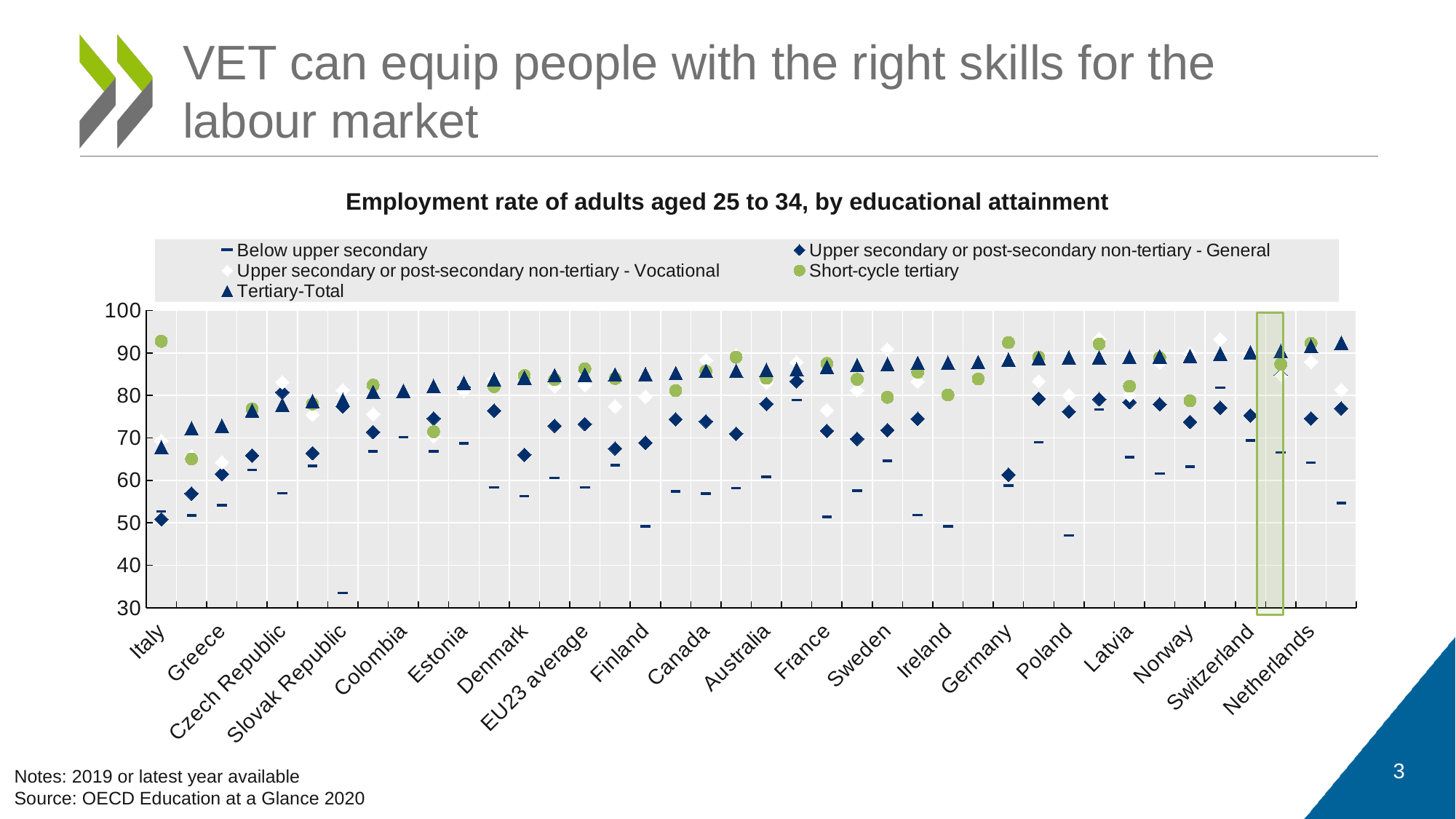
What kind of chart is shown on the slide? Scatter chart Which country has the lowest Below upper secondary employment rate? Slovak Republic What is the title of the chart? Employment rate of adults aged 25 to 34, by educational attainment Which has the larger Tertiary-Total employment rate, Italy or the Netherlands? Netherlands Is the Below upper secondary value for Italy greater or less than 60? less How many series does the chart legend list? 5 Is the Below upper secondary value for Poland greater or less than 50? less Is the Tertiary-Total value for the Netherlands greater or less than 90? greater